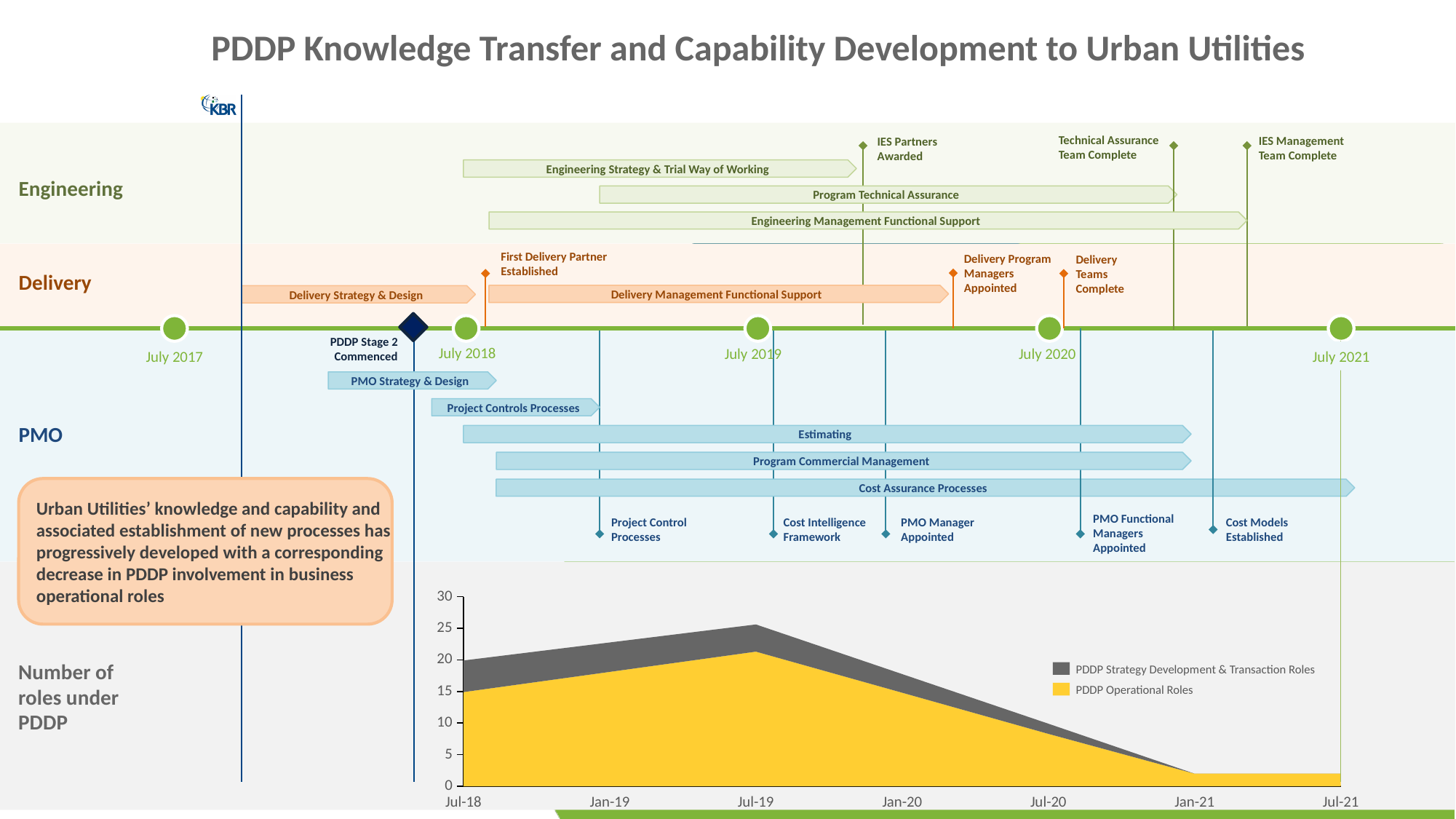
In the 'Number of roles under PDDP' chart, do the PDDP Operational Roles rise or fall between Jul-19 and Jul-21? fall How many dates are labelled on the x axis of the 'Number of roles under PDDP' chart? 7 In the 'Number of roles under PDDP' chart, is the value for PDDP Operational Roles at Jul-21 greater or less than 5? less In the 'Number of roles under PDDP' chart, do the PDDP Operational Roles rise or fall between Jul-18 and Jul-19? rise In the 'Number of roles under PDDP' chart, which colour represents PDDP Operational Roles? Yellow In the 'Number of roles under PDDP' chart, is the total number of roles at Jul-18 greater or less than 15? greater What is the highest value shown on the y axis of the 'Number of roles under PDDP' chart? 30 In the 'Number of roles under PDDP' chart, at which x-axis date do PDDP Operational Roles reach their highest value? Jul-19 In the 'Number of roles under PDDP' chart, is the value for PDDP Operational Roles at Jul-19 greater or less than 20? greater What kind of chart is the 'Number of roles under PDDP' chart at the bottom of the slide? Stacked area chart How many series does the legend of the 'Number of roles under PDDP' chart list? 2